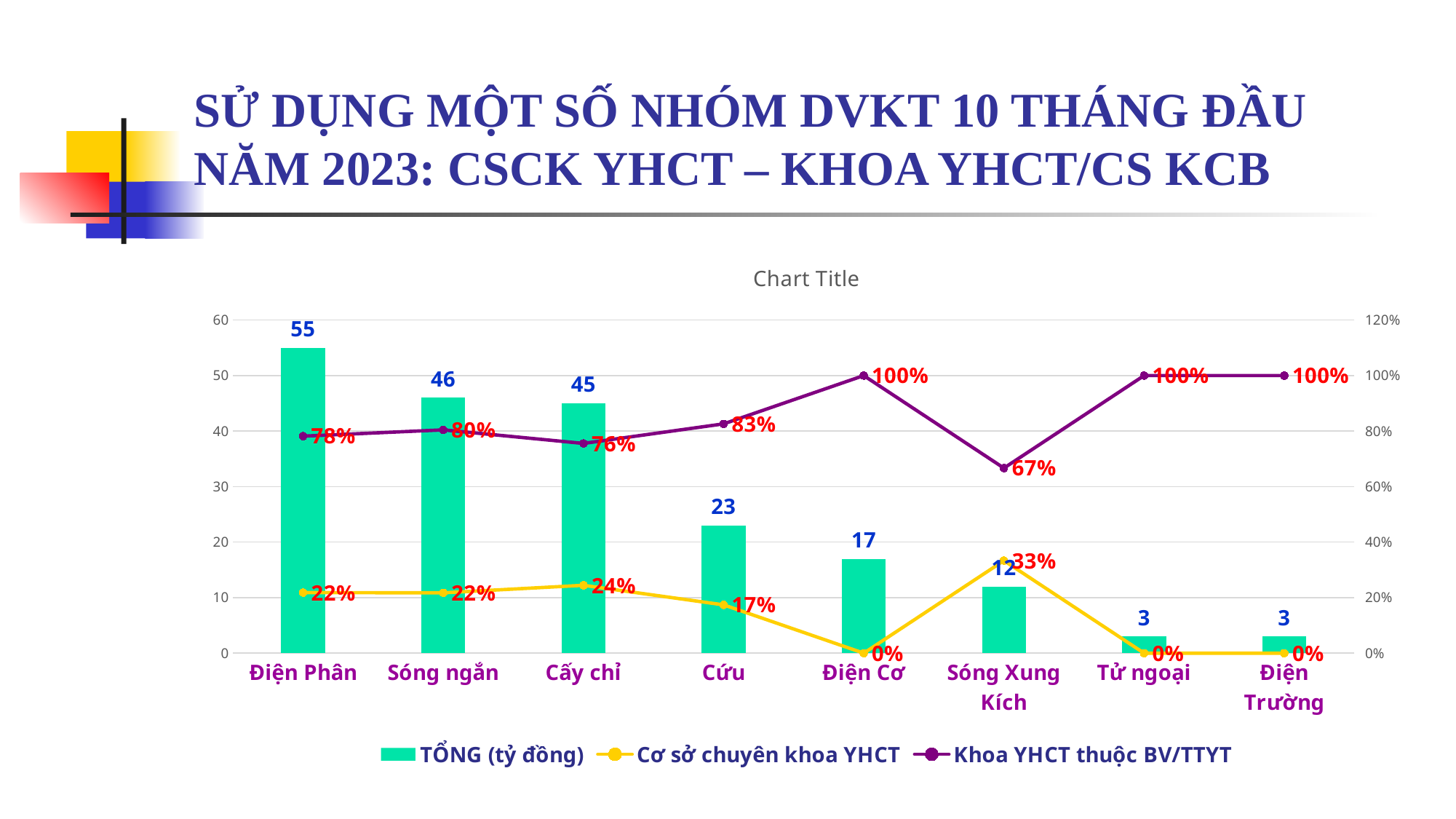
What is the TỔNG (tỷ đồng) value for Điện Phân? 55 Do the TỔNG (tỷ đồng) bar values rise or fall from Điện Phân to Điện Trường? Fall How many series does the legend list? 3 Which category has the lowest Khoa YHCT thuộc BV/TTYT value? Sóng Xung Kích Which category has the highest TỔNG (tỷ đồng) value? Điện Phân How many categories are shown on the x axis? 8 Which is larger, the Cơ sở chuyên khoa YHCT value for Sóng Xung Kích or for Cứu? Sóng Xung Kích What is the Cơ sở chuyên khoa YHCT value for Cấy chỉ? 24% What kind of chart is this? Combined bar and line chart What is the Khoa YHCT thuộc BV/TTYT value for Sóng Xung Kích? 67% What is the difference between the TỔNG (tỷ đồng) values for Sóng ngắn and Cứu? 23 Which series is drawn as bars? TỔNG (tỷ đồng)